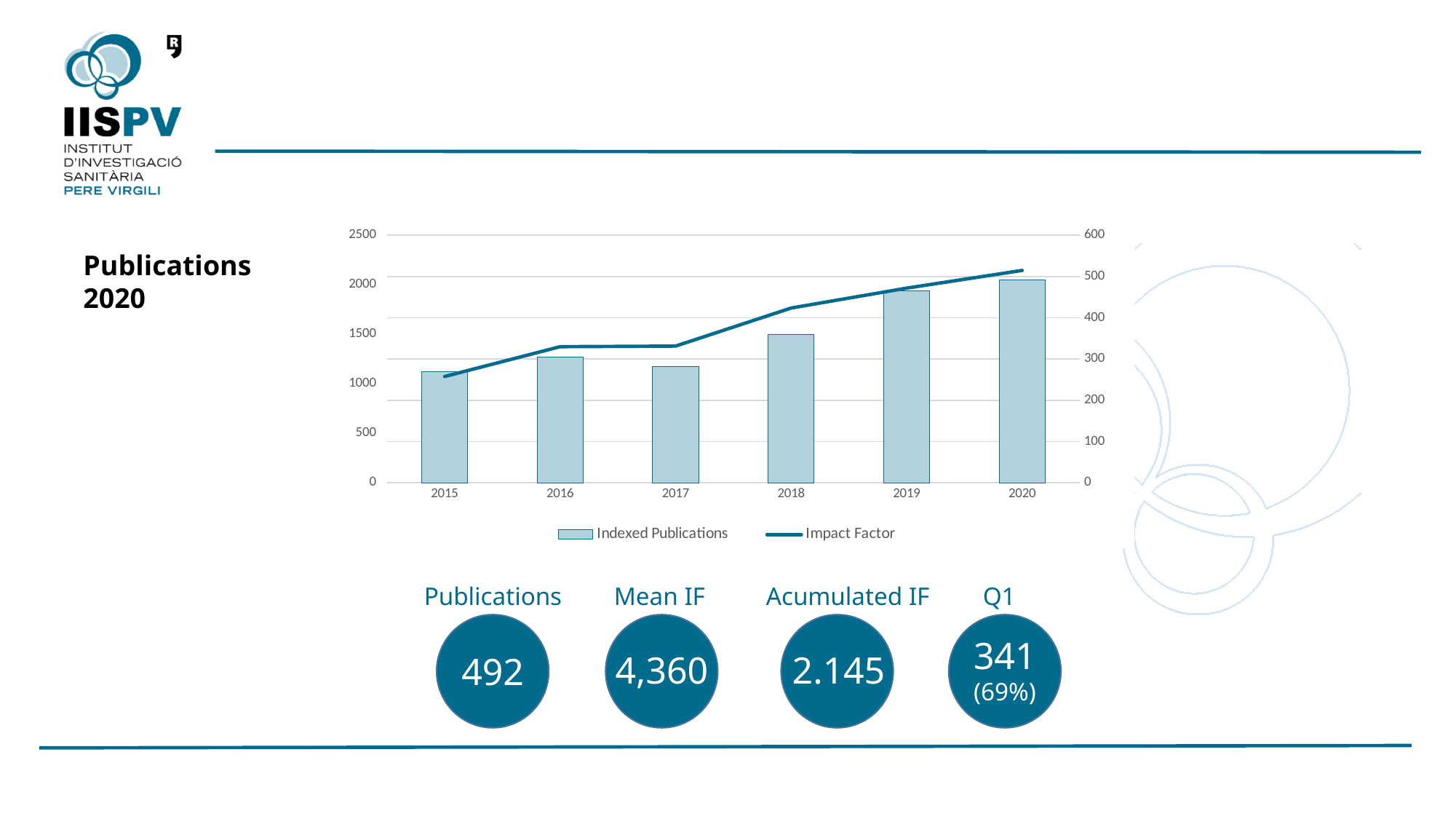
How many years are shown on the x axis of the chart? 6 Is the Indexed Publications value for 2019 greater or less than 1500? greater Which year has the highest Impact Factor value on the line? 2020 What kind of chart is shown on the slide? A combined bar and line chart Is the Impact Factor value for 2020 greater or less than 400? greater Which year has the highest number of Indexed Publications? 2020 What are the two series named in the chart legend? Indexed Publications and Impact Factor Which year has more Indexed Publications, 2016 or 2017? 2016 How many series does the chart legend list? 2 Does the Impact Factor line generally rise or fall from 2015 to 2020? rise Is the Indexed Publications value for 2015 greater or less than 1500? less Which year has the lowest Impact Factor value on the line? 2015